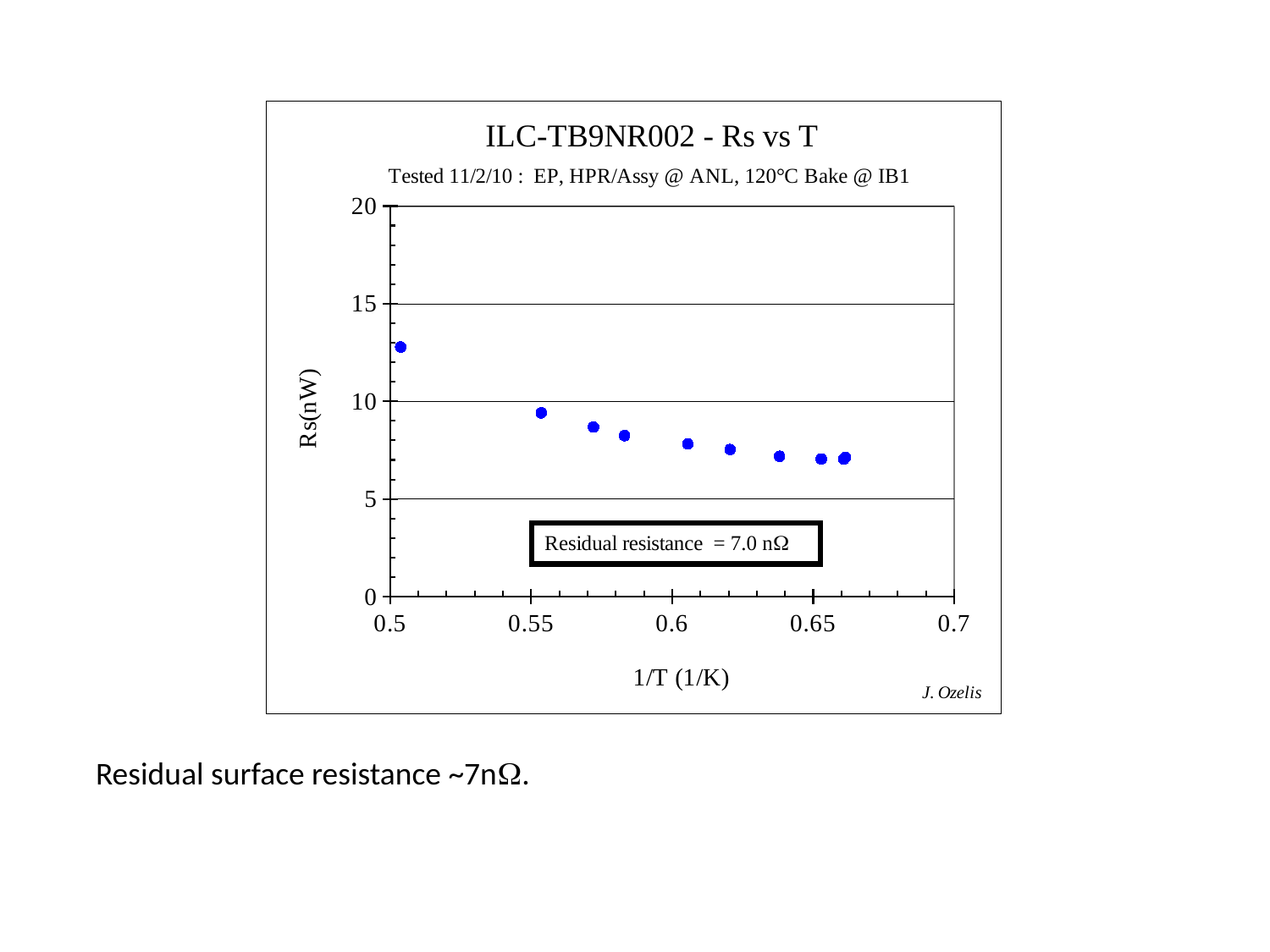
Do the Rs values rise or fall as 1/T increases along the x axis? Fall At which x-axis position is the point with the highest Rs value located? Near 0.5 Is the Rs value of the rightmost point (near 1/T = 0.66) greater or less than 5 nW? greater What is the label of the x axis? 1/T (1/K) What kind of chart is shown on the slide? Scatter plot What is the maximum value shown on the y axis? 20 Is the Rs value of the point near 1/T = 0.55 greater or less than 10 nW? less What residual resistance value is stated in the box on the chart? 7.0 nΩ Is the Rs value of the leftmost point (near 1/T = 0.5) greater or less than 10 nW? greater What is the title of the chart? ILC-TB9NR002 - Rs vs T Which point has the highest Rs value: the one near 1/T = 0.5 or the one near 1/T = 0.65? The one near 1/T = 0.5